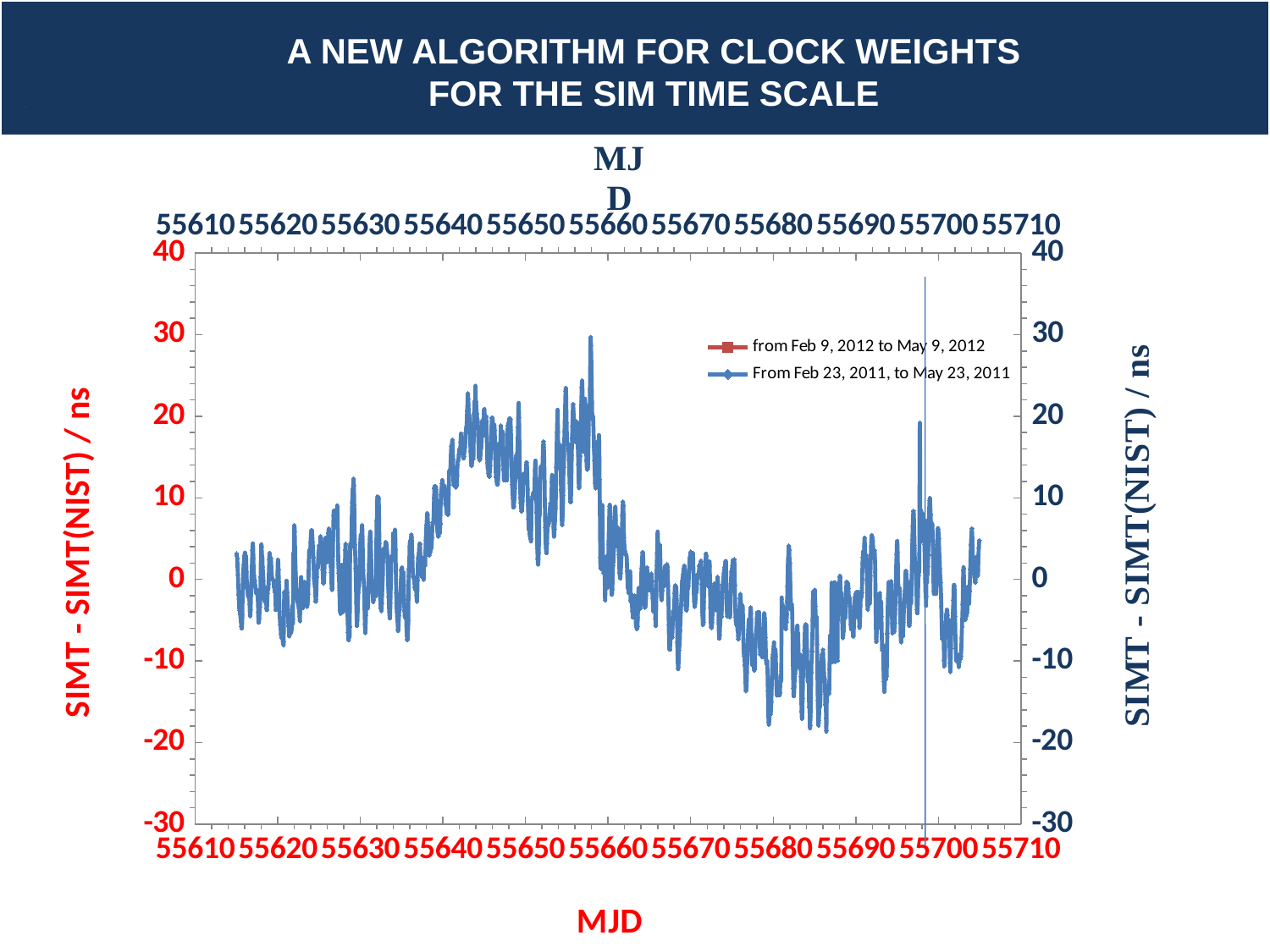
How many series does the legend list? 2 Is the highest value reached by the plotted series greater or less than 40? less What kind of chart is shown on the slide? line chart Between MJD 55630 and MJD 55645, does the series generally rise or fall? rise Is the lowest value reached by the plotted series greater or less than -10? less Is the highest value reached by the plotted series greater or less than 20? greater What are the two entries in the chart legend? from Feb 9, 2012 to May 9, 2012; From Feb 23, 2011, to May 23, 2011 Between MJD 55660 and MJD 55685, does the series generally rise or fall? fall Which is larger: the series value around MJD 55645 or around MJD 55685? around MJD 55645 What is the title of the x axis at the bottom of the chart? MJD